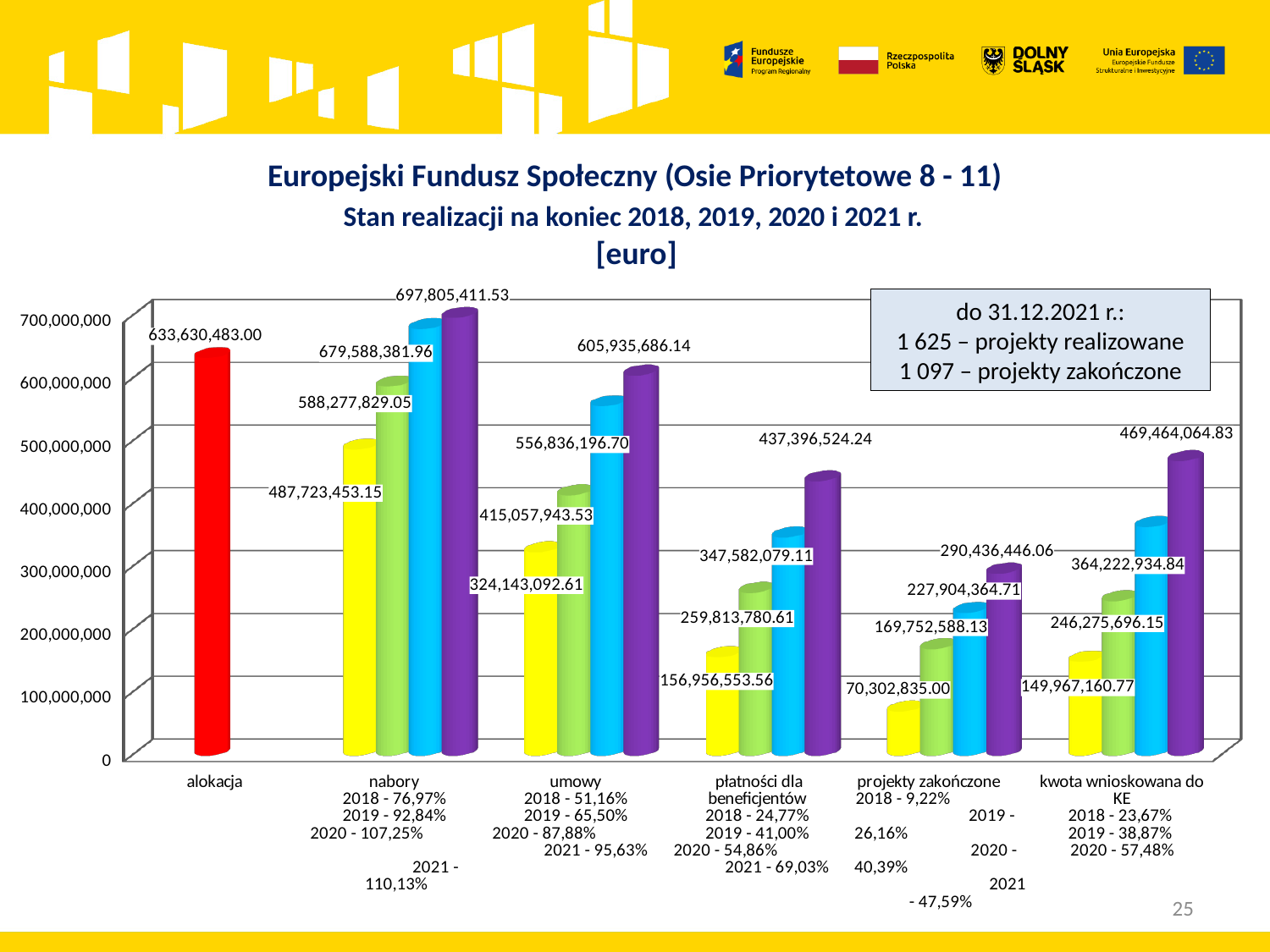
What type of chart is shown on the slide? bar chart How many category groups are shown on the x axis? 6 What is the difference between the tallest bar in the nabory group (697,805,411.53) and the alokacja bar (633,630,483.00)? 64,174,928.53 What is the value of the shortest (yellow) bar in the projekty zakończone group? 70,302,835.00 What is the value of the tallest (purple) bar in the nabory group? 697,805,411.53 What is the value of the shortest (yellow) bar in the umowy group? 324,143,092.61 What is the value of the alokacja bar? 633,630,483.00 Which is larger: the purple bar in the umowy group or the alokacja bar? the alokacja bar What is the value of the tallest (purple) bar in the płatności dla beneficjentów group? 437,396,524.24 Which category group contains the lowest bar on the chart? projekty zakończone What is the value of the blue bar in the kwota wnioskowana do KE group? 364,222,934.84 Which category group contains the highest bar on the chart? nabory